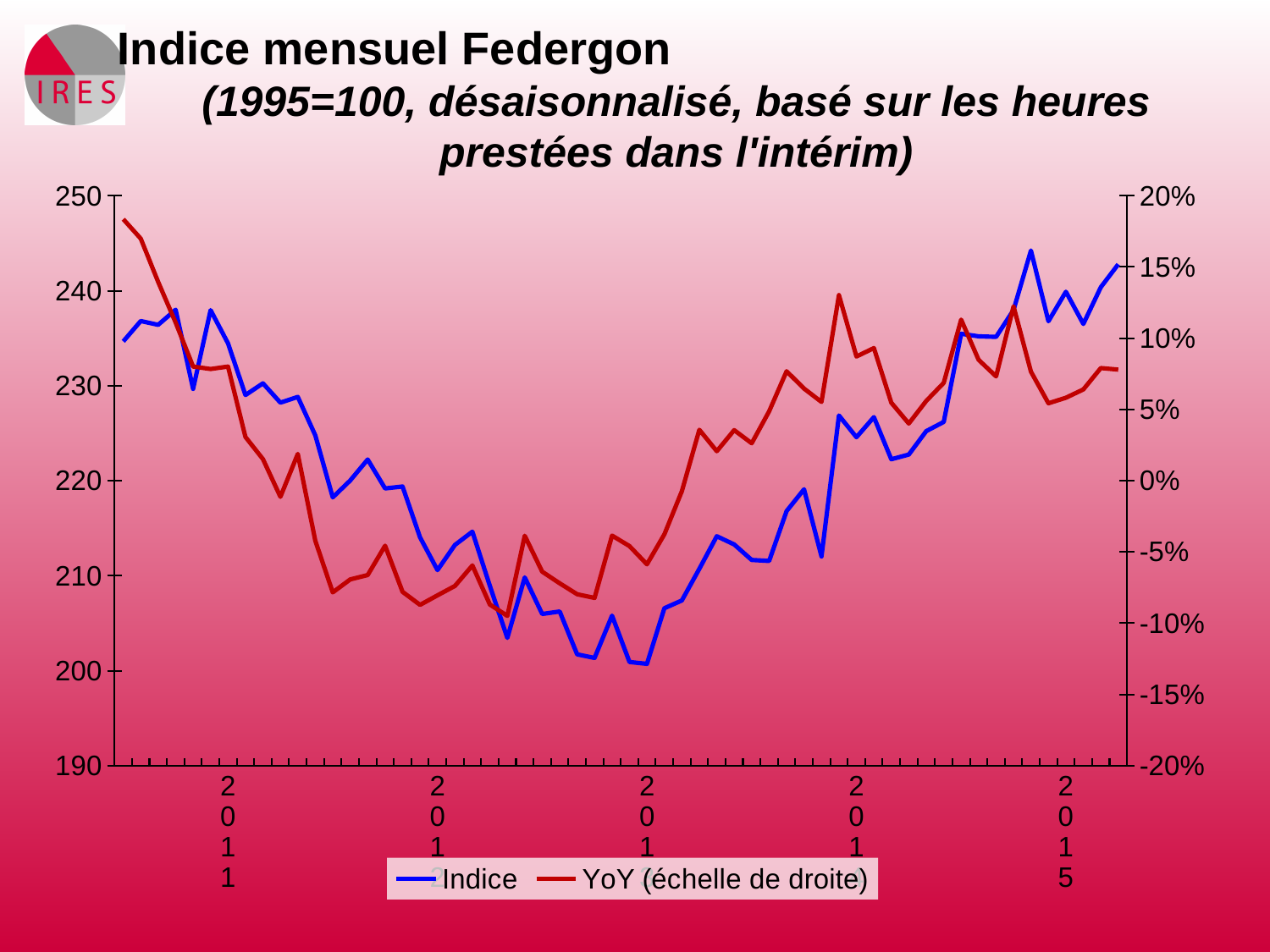
What are the two series named in the legend? Indice and YoY (échelle de droite) How many series does the legend list? 2 What kind of chart is shown on the slide? line chart Does the Indice series rise or fall between 2013 and 2015? rise Is the value of the Indice series at the end of the chart (2015) greater or less than 240? greater Is the lowest value of the Indice series greater or less than 210? less Is the value of the Indice series at the start of the chart (2011) greater or less than 230? greater What is the maximum value shown on the left-hand axis? 250 Which series is plotted against the right-hand axis? YoY (échelle de droite) Does the Indice series rise or fall between 2011 and 2013? fall